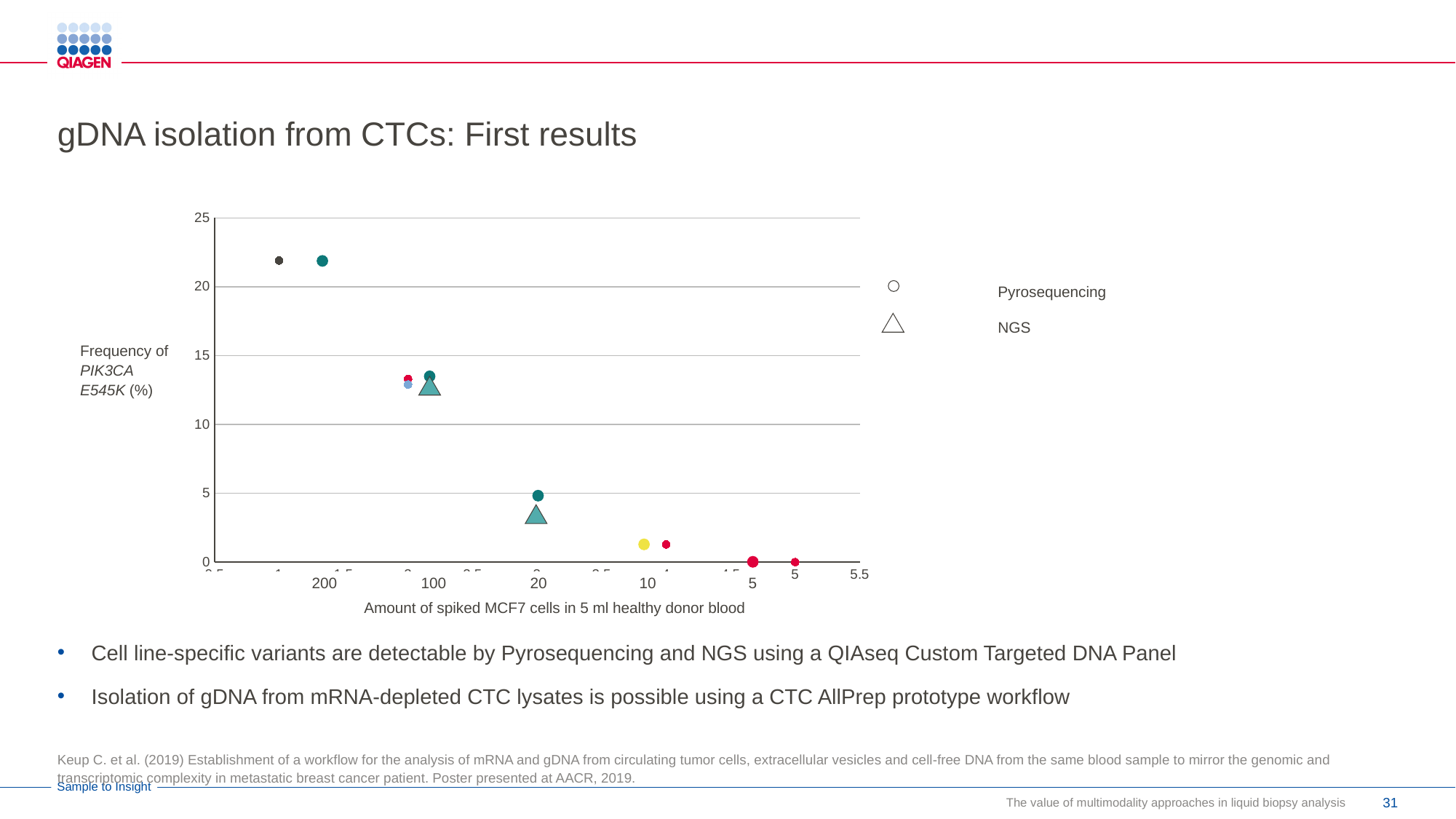
Is the Pyrosequencing frequency at 10 spiked MCF7 cells greater or less than 5? less What kind of chart is shown on the slide? Scatter chart Is the Pyrosequencing frequency at 100 spiked MCF7 cells greater or less than 10? greater Is the Pyrosequencing frequency at 200 spiked MCF7 cells greater or less than 20? greater How many amounts of spiked MCF7 cells are labelled on the x axis? 5 What are the two series named in the legend? Pyrosequencing and NGS Do the PIK3CA E545K frequencies rise or fall as the amount of spiked cells goes from 200 to 5 along the x axis? Fall Which amount of spiked MCF7 cells shows the highest PIK3CA E545K frequency? 200 How many series does the legend list? 2 Which marker shape represents NGS in the legend? Triangle